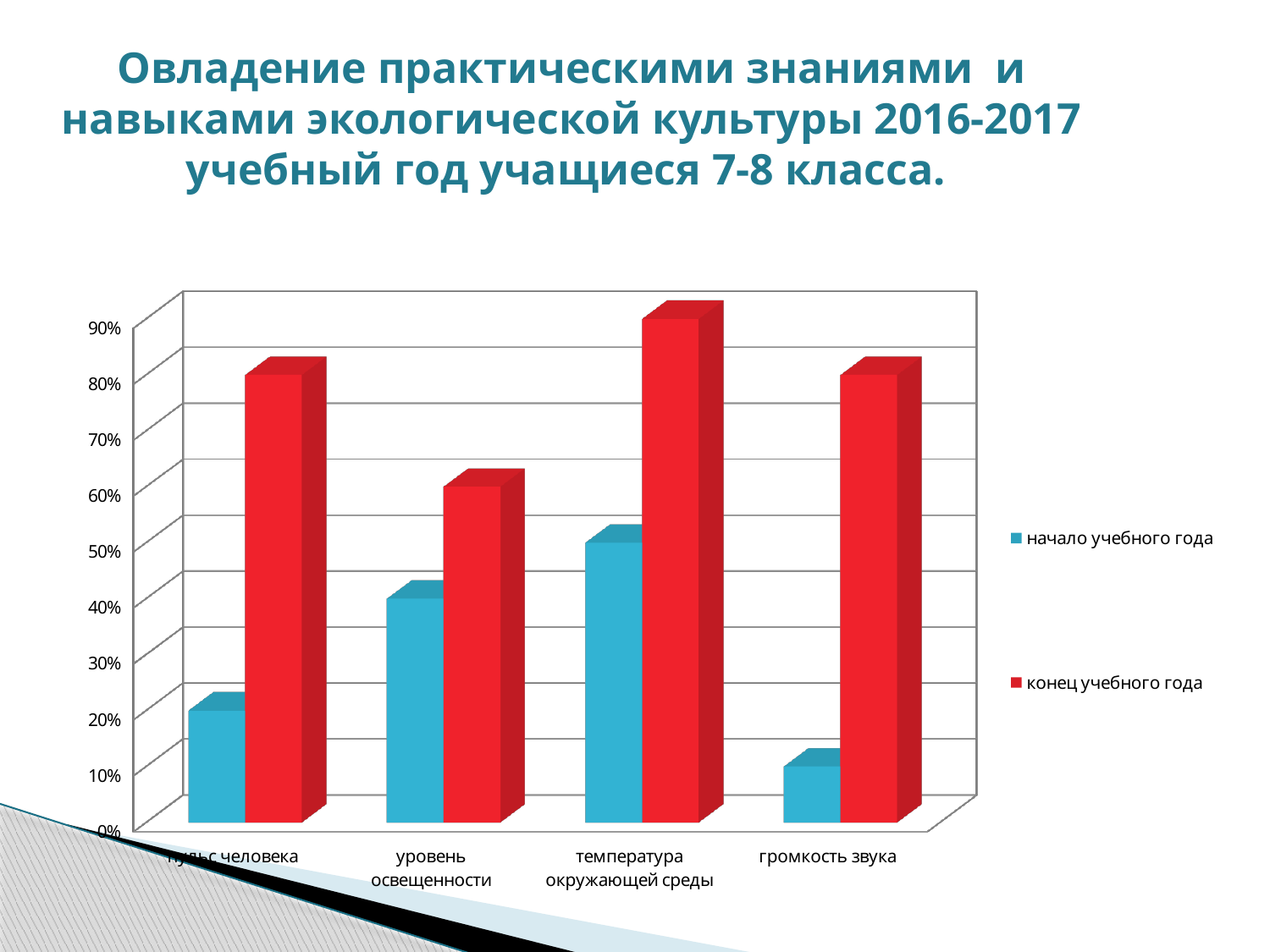
How many series does the legend list? 2 Is the value for конец учебного года for уровень освещенности greater or less than 70%? less Which category has the lowest value for конец учебного года? уровень освещенности What colour are the bars for конец учебного года? red For громкость звука, which is larger: начало учебного года or конец учебного года? конец учебного года What kind of chart is shown on the slide? bar chart Which category has the highest value for начало учебного года? температура окружающей среды Is the value for начало учебного года for пульс человека greater or less than 30%? less Which category has the lowest value for начало учебного года? громкость звука How many categories are shown on the x axis? 4 Which category has the highest value for конец учебного года? температура окружающей среды Is the value for конец учебного года for температура окружающей среды greater or less than 80%? greater